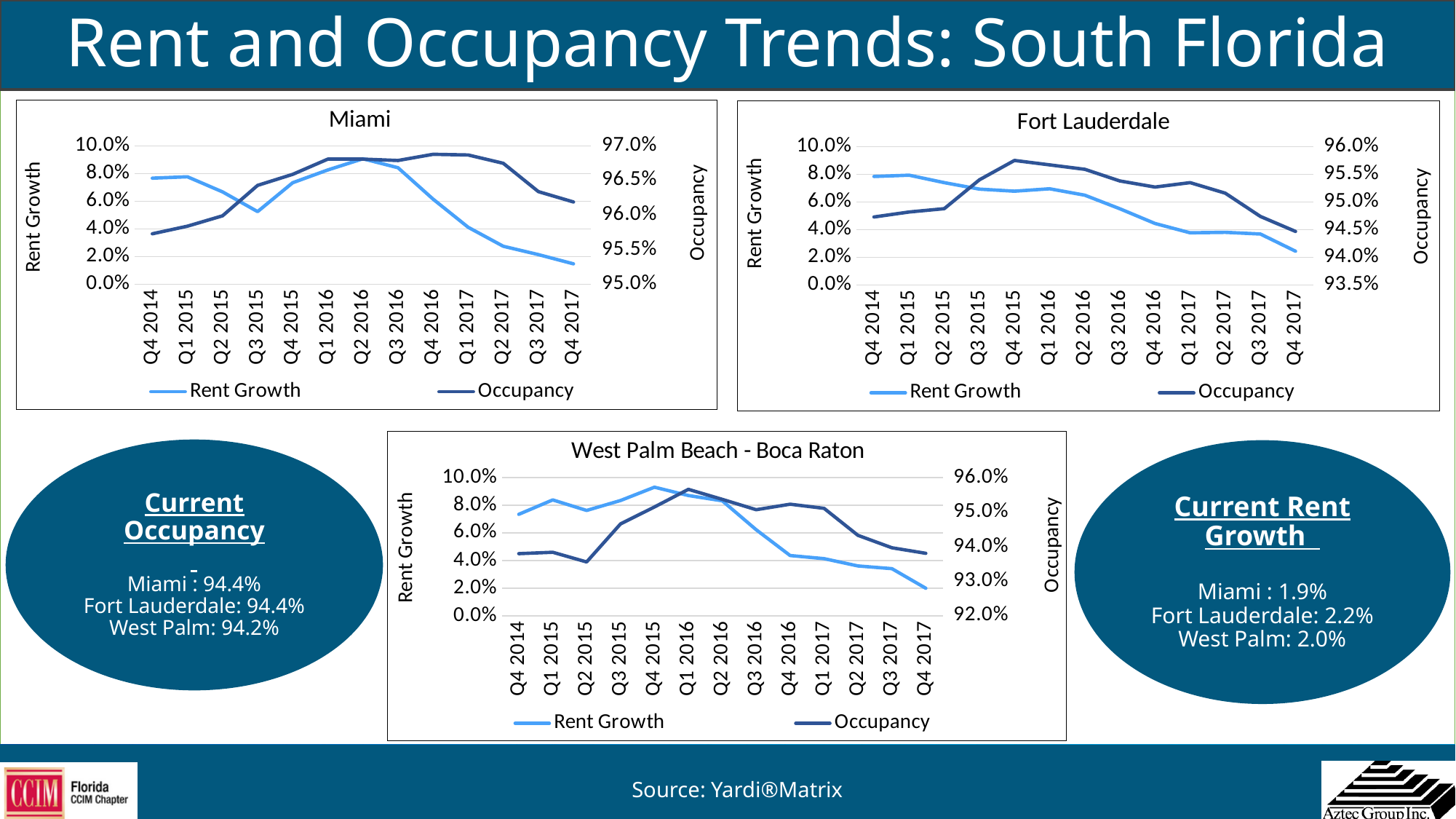
In the Fort Lauderdale chart, in which quarter does Occupancy reach its highest point? Q4 2015 What kind of chart is the Miami chart? line chart In the West Palm Beach - Boca Raton chart, which is larger: Occupancy in Q1 2016 or Occupancy in Q4 2017? Q1 2016 In the Fort Lauderdale chart, is the Rent Growth value for Q4 2017 greater or less than 4.0%? less How many series does the legend of the Fort Lauderdale chart list? 2 In the Miami chart, is the Rent Growth value for Q4 2014 greater or less than 6.0%? greater In the Fort Lauderdale chart, in which quarter is Rent Growth lowest? Q4 2017 How many quarters are plotted along the x axis of the West Palm Beach - Boca Raton chart? 13 In the Miami chart, does Rent Growth rise or fall from Q3 2016 to Q4 2017? fall In the Miami chart, in which quarter does Rent Growth reach its highest point? Q2 2016 According to the Current Rent Growth box, what is the difference between Fort Lauderdale's rent growth (2.2%) and Miami's rent growth (1.9%)? 0.3 percentage points In the West Palm Beach - Boca Raton chart, is the Rent Growth value for Q4 2015 greater or less than 8.0%? greater